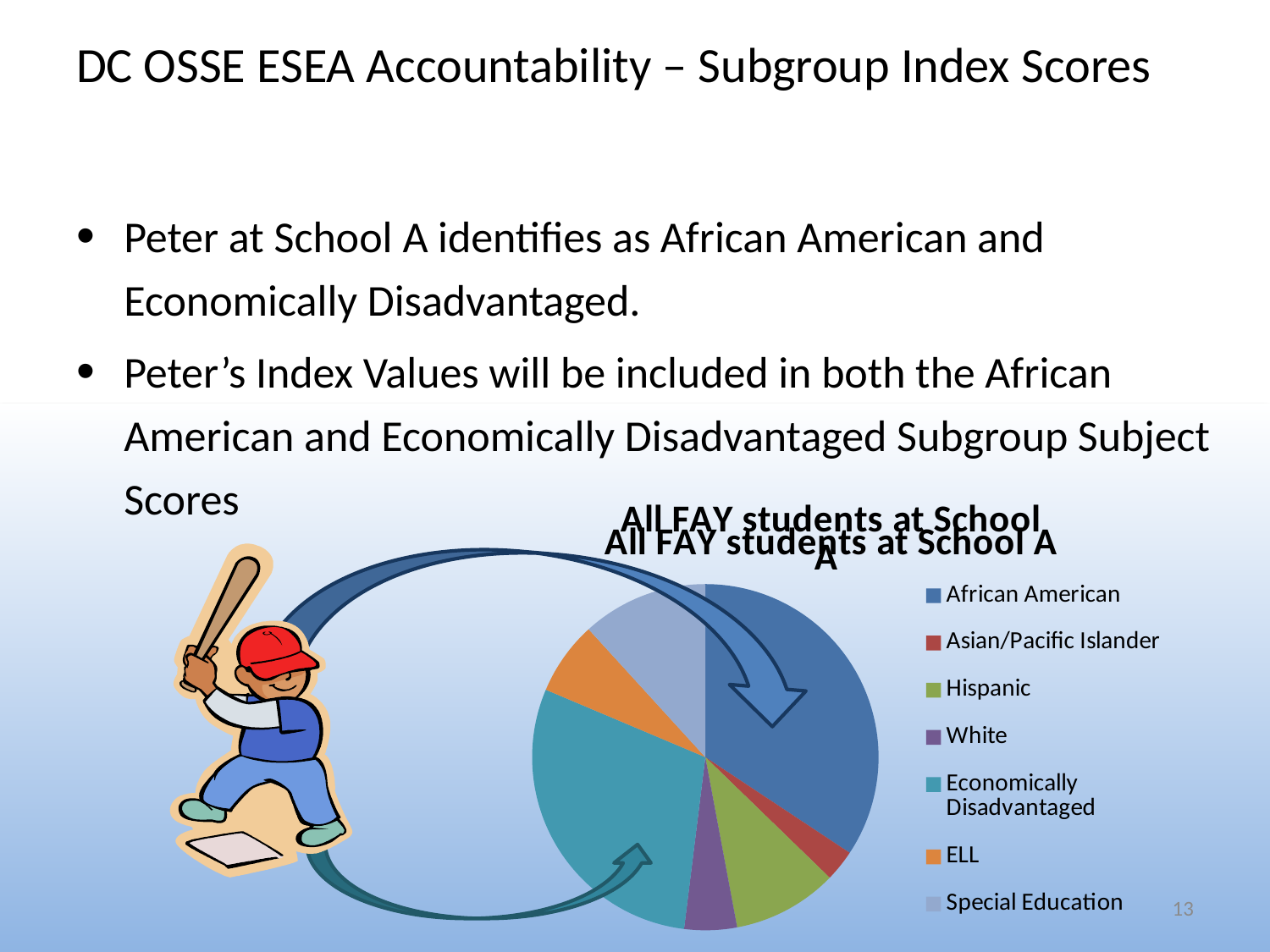
Which category has the smallest slice in the pie chart? Asian/Pacific Islander Which category has the largest slice in the pie chart? African American Which slice is larger in the pie chart, Hispanic or White? Hispanic How many categories does the legend of the pie chart list? 7 What kind of chart is shown on the slide? pie chart What is the title of the pie chart? All FAY students at School A Which slice is larger in the pie chart, Economically Disadvantaged or Hispanic? Economically Disadvantaged Which legend entry in the pie chart is shown in orange? ELL Which slice is larger in the pie chart, African American or Asian/Pacific Islander? African American